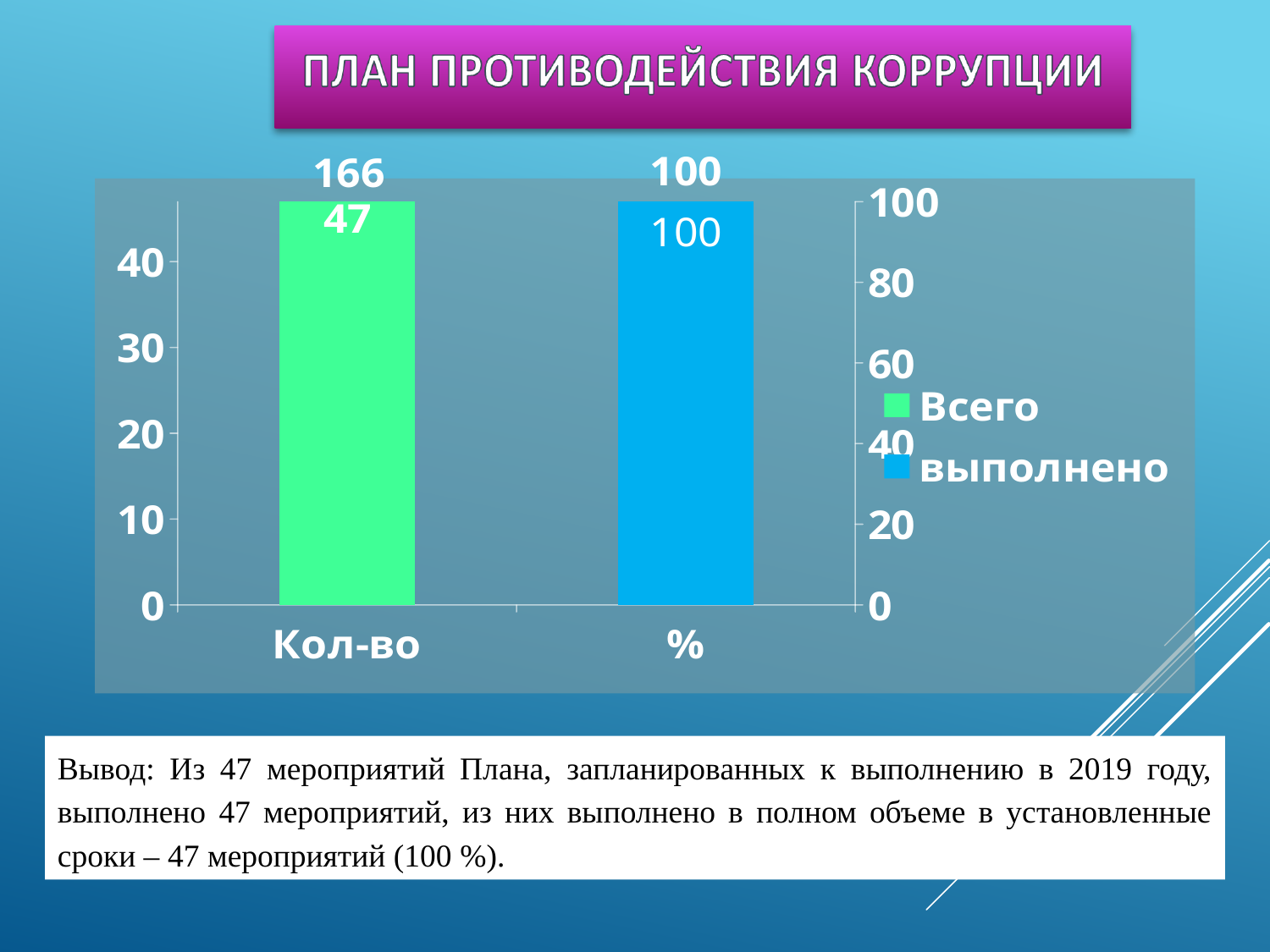
Which legend entry is shown in green? Всего What is the highest tick value shown on the right-hand axis? 100 What value is labelled on the green bar for the category "Кол-во"? 47 Is the value of the "Кол-во" bar greater or less than 40 on the left axis? greater Is the value of the "%" bar greater or less than 80 on the right axis? greater What value is labelled on the blue bar for the category "%"? 100 What is the highest tick value shown on the left-hand axis? 40 How many series does the chart legend list? 2 Which legend entry is shown in blue? выполнено What kind of chart is shown on the slide? bar chart How many categories are shown on the x axis of the chart? 2